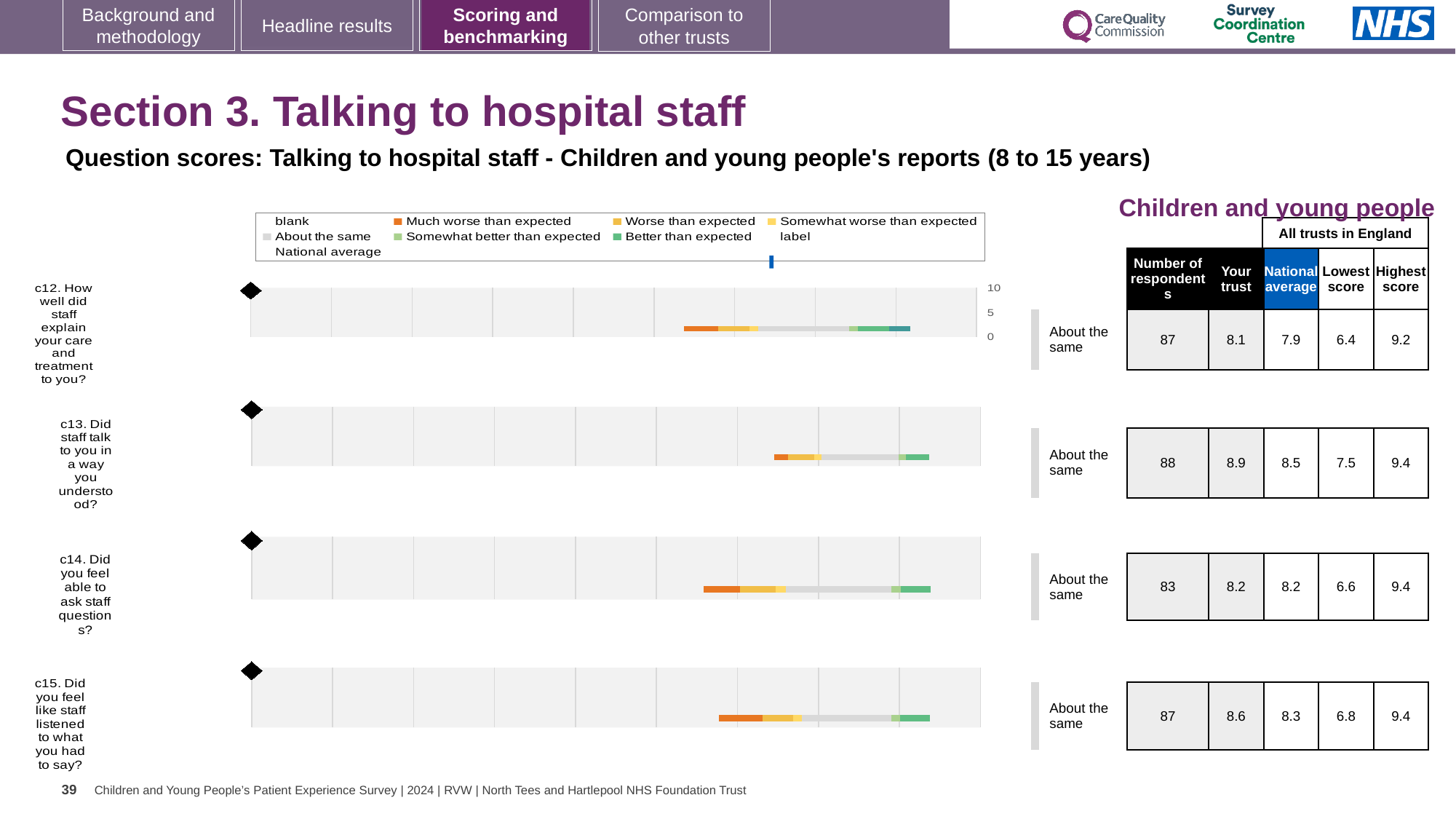
How many questions (c12 to c15) have a chart on the slide? 4 What benchmark label is shown next to the chart for c12? About the same How many respondents answered c14 (Did you feel able to ask staff questions?)? 83 Which question has the lowest 'Your trust' score? c12 For c15, which is larger: the 'Your trust' score or the national average? Your trust What is the highest score across all trusts in England for c12? 9.2 What is the 'Your trust' score for c13 (Did staff talk to you in a way you understood?)? 8.9 What kind of chart is used to show the question scores for c12 to c15? bar chart Is the coloured bar for c12 positioned greater or less than 5 on the axis? greater Which question has the highest 'Your trust' score? c13 For c13, what is the difference between the 'Your trust' score and the national average? 0.4 What colour does the legend use for 'Much worse than expected'? orange